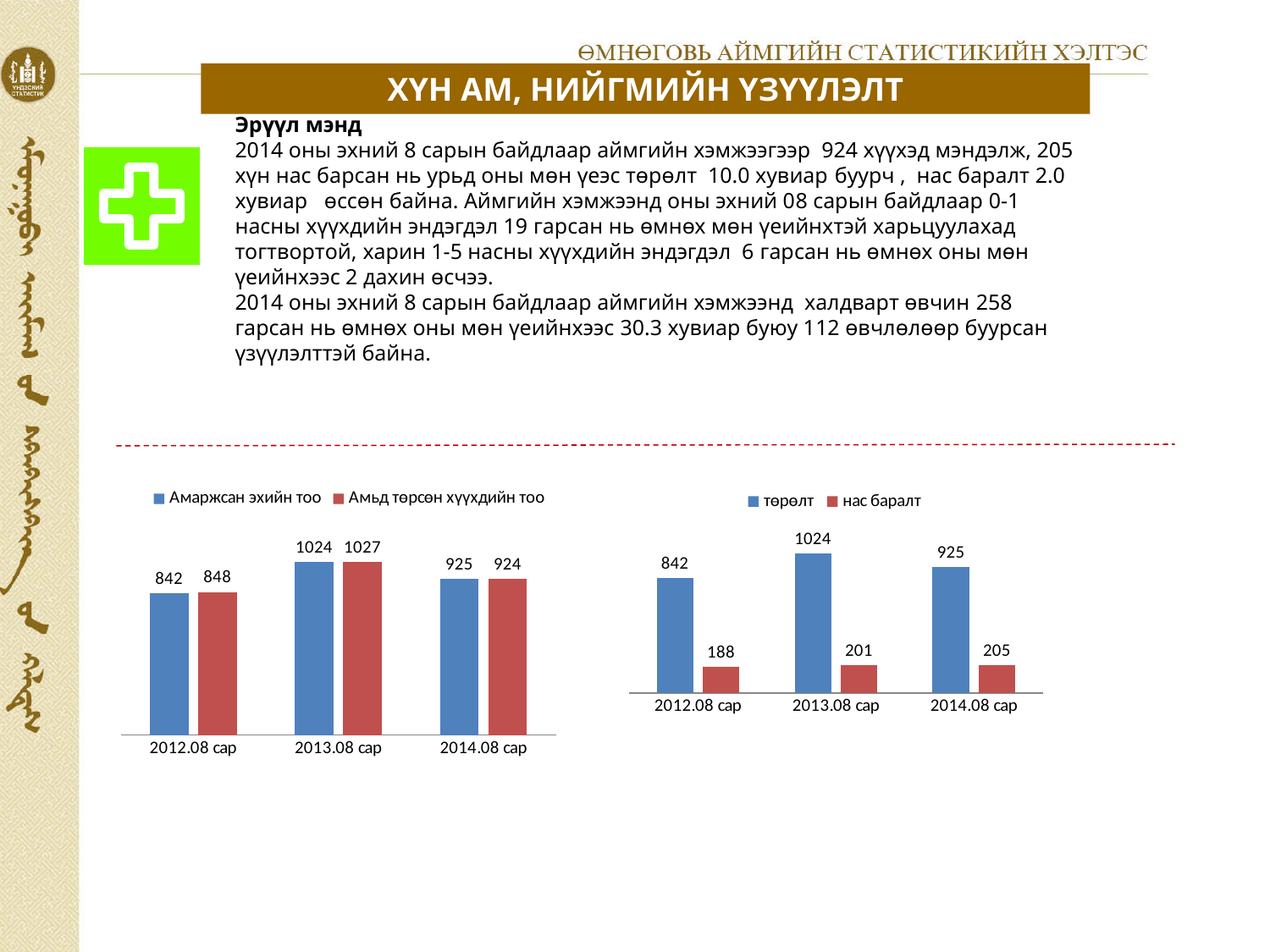
In the left chart, how many series does the legend list? 2 In the right chart, what is the value of нас баралт for 2014.08 сар? 205 What type of chart is the right chart? Bar chart In the left chart, which category has the lowest value for Амаржсан эхийн тоо? 2012.08 сар In the left chart, what is the difference between Амьд төрсөн хүүхдийн тоо for 2013.08 сар and 2014.08 сар? 103 In the left chart, which category has the highest value for Амьд төрсөн хүүхдийн тоо? 2013.08 сар In the left chart, what is the value of Амаржсан эхийн тоо for 2013.08 сар? 1024 In the right chart, which category has the lowest value for нас баралт? 2012.08 сар In the right chart, is the value of төрөлт for 2013.08 сар larger than the value for 2014.08 сар? Yes In the right chart, what is the value of төрөлт for 2012.08 сар? 842 In the left chart, what is the value of Амьд төрсөн хүүхдийн тоо for 2012.08 сар? 848 In the right chart, what is the difference between төрөлт and нас баралт for 2014.08 сар? 720